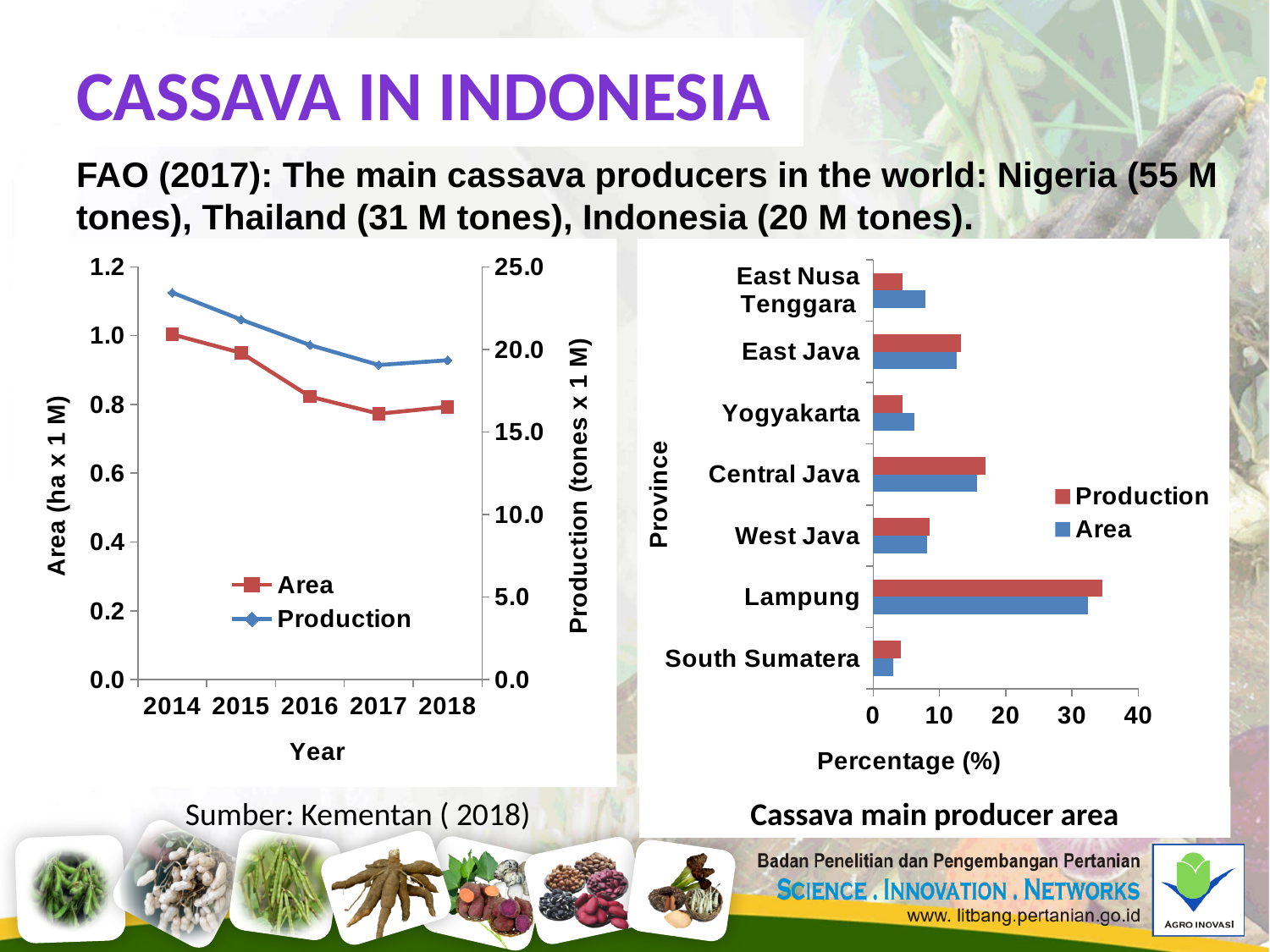
In the 'Cassava main producer area' chart, is the Production value for Lampung greater or less than 30? greater In the 'Cassava main producer area' chart, which province has the lowest Area percentage? South Sumatera In the left line chart, is the Production value for 2014 greater or less than 20.0? greater In the 'Cassava main producer area' chart, which has the larger Production percentage, Central Java or East Java? Central Java In the 'Cassava main producer area' chart, which province has the highest Production percentage? Lampung In the left line chart, how many years are shown on the x axis? 5 What kind of chart is the left chart showing Area and Production by year? line chart What kind of chart is the right chart titled 'Cassava main producer area'? bar chart In the 'Cassava main producer area' chart, how many provinces are listed? 7 In the left line chart, is the Area value for 2017 greater or less than 0.8? less In the left line chart, how many series does the legend list? 2 In the left line chart, does the Area series rise or fall from 2014 to 2017? fall